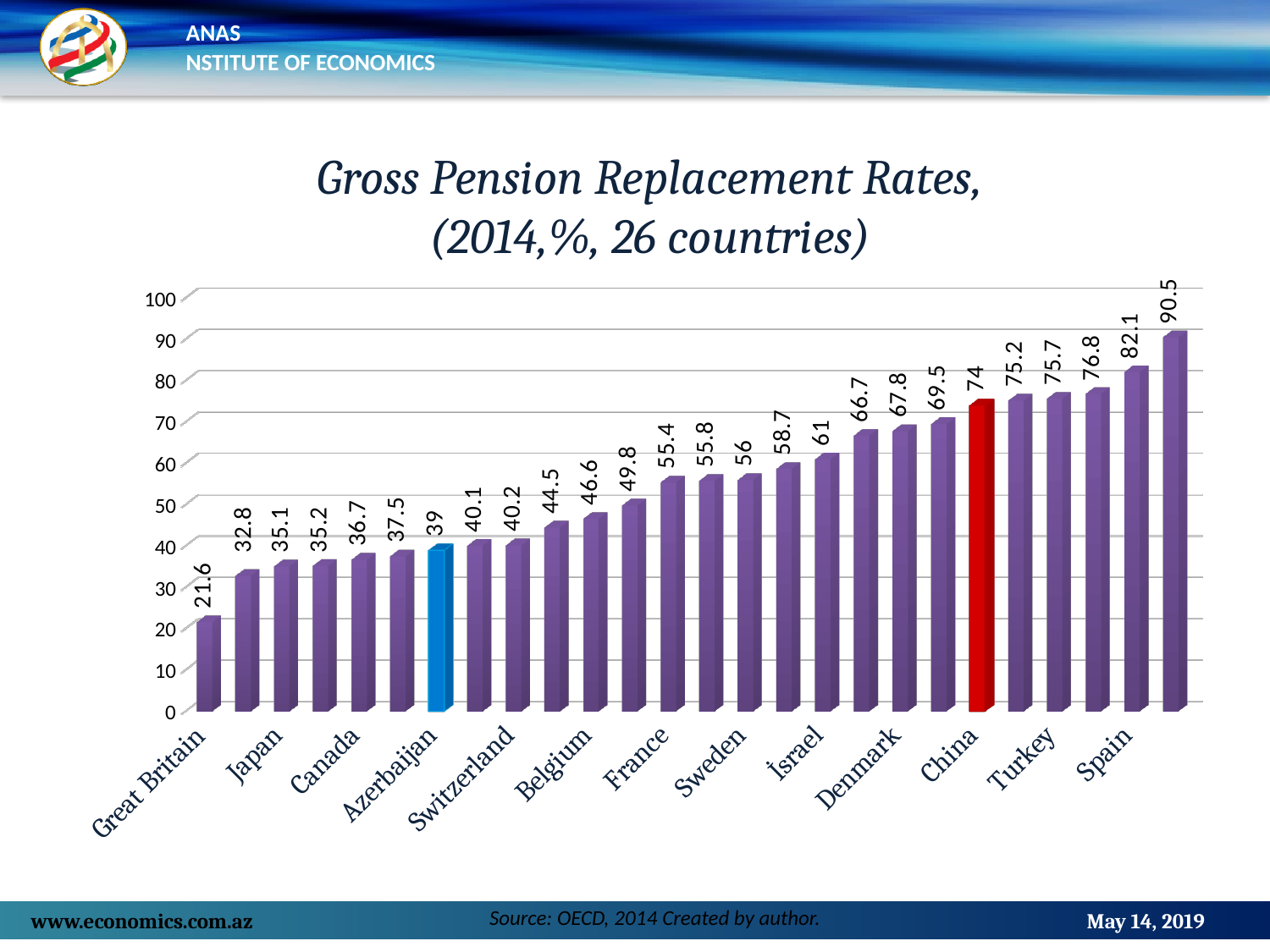
What is the gross pension replacement rate for Azerbaijan (the blue bar)? 39 Do the values rise or fall moving from left to right along the x axis? rise Which has a higher gross pension replacement rate, China or Azerbaijan? China What is the gross pension replacement rate for Great Britain? 21.6 How many countries are plotted on the chart? 26 What kind of chart is shown on the slide? bar chart Which country has the lowest gross pension replacement rate on the chart? Great Britain What is the title of the chart? Gross Pension Replacement Rates, (2014,%, 26 countries) What is the gross pension replacement rate for China (the red bar)? 74 What is the difference between the values for China and Azerbaijan? 35 What is the highest value shown on the chart? 90.5 What colour is the bar for Azerbaijan? blue